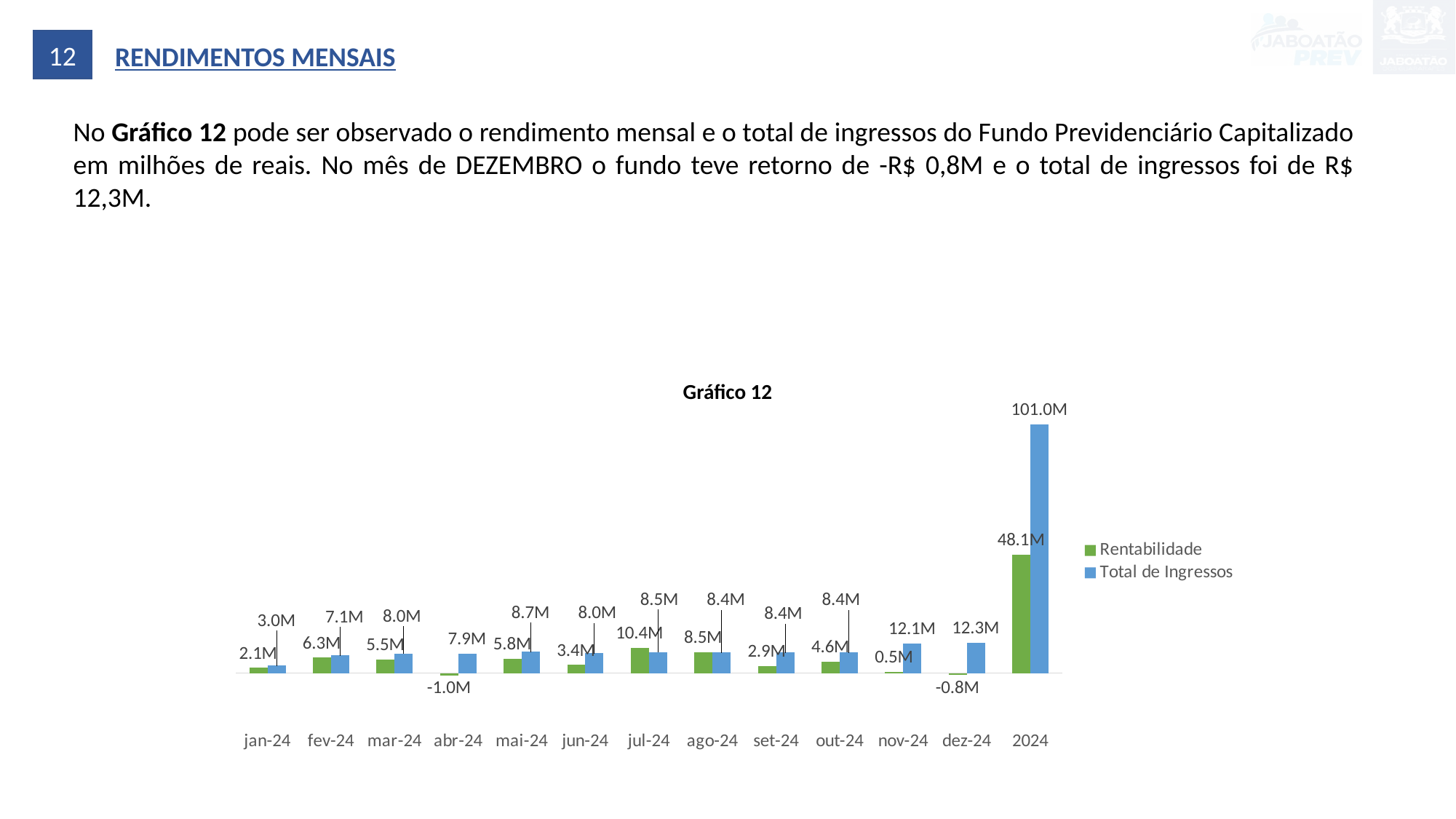
How many categories are shown on the x axis? 13 What kind of chart is shown on the slide? Bar chart Which category has the lowest Rentabilidade value? abr-24 What is the Total de Ingressos value for dez-24? 12.3M What is the difference between Total de Ingressos and Rentabilidade for the 2024 category? 52.9M What is the Rentabilidade value for abr-24? -1.0M What is the title of the chart? Gráfico 12 What is the Total de Ingressos value for the 2024 category? 101.0M Which is larger for jul-24: Rentabilidade or Total de Ingressos? Rentabilidade What is the Rentabilidade value for jul-24? 10.4M How many series does the legend list? 2 Which month (excluding the 2024 total) has the highest Rentabilidade? jul-24